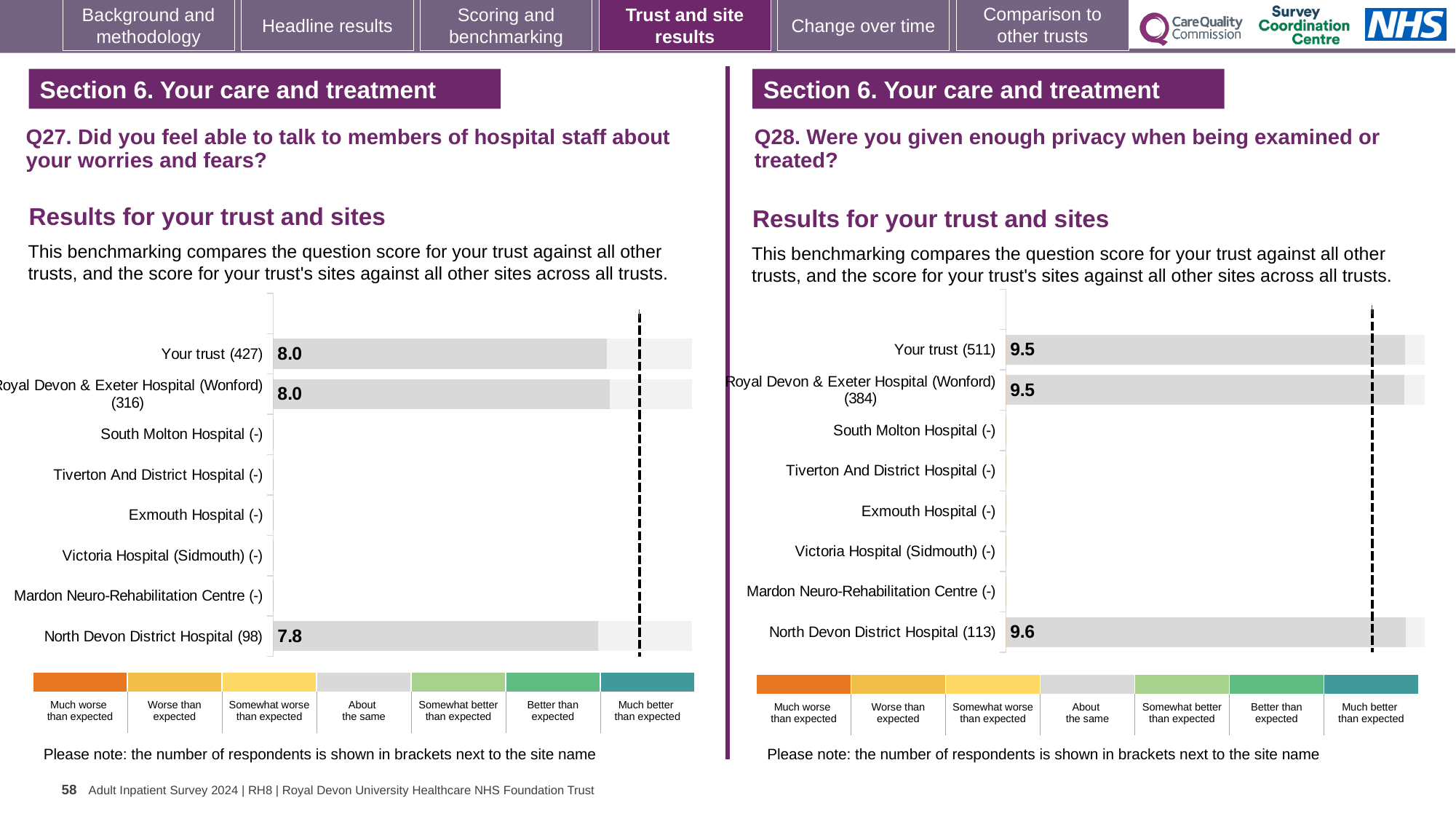
On the Q28 chart (right), what is the difference between the score for North Devon District Hospital (113) and Your trust (511)? 0.1 How many categories (rows) are listed on the Q27 chart (left)? 8 What kind of chart is used on the Q28 chart (right)? Bar chart On the Q28 chart (right), which site with a plotted score has the highest value? North Devon District Hospital (113) On the Q28 chart (right), which is larger: the score for Your trust (511) or North Devon District Hospital (113)? North Devon District Hospital (113) On the Q28 chart (right), what is the score for Your trust (511)? 9.5 On the Q28 chart (right), what is the score for North Devon District Hospital (113)? 9.6 On the Q27 chart (left), what is the score for North Devon District Hospital (98)? 7.8 On the Q27 chart (left), which site with a plotted score has the lowest value? North Devon District Hospital (98) On the Q27 chart (left), what is the difference between the score for Your trust (427) and North Devon District Hospital (98)? 0.2 On the Q28 chart (right), what is the score for Royal Devon & Exeter Hospital (Wonford) (384)? 9.5 On the Q27 chart (left), what is the score for Your trust (427)? 8.0